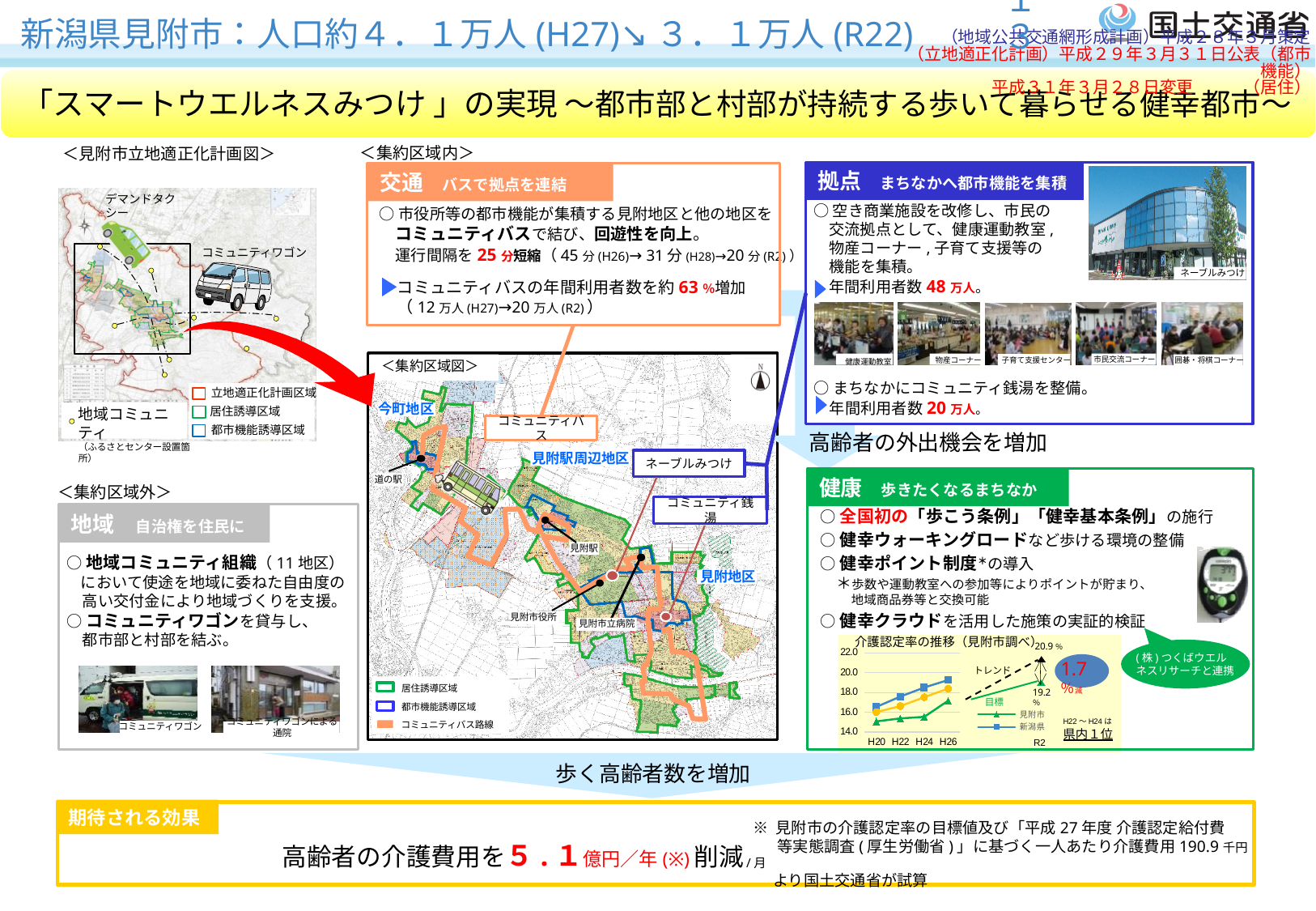
In the 介護認定率の推移 chart, does the 見附市 line rise or fall from H20 to H26? rise In the 介護認定率の推移 chart, is the 見附市 value at H20 greater or less than 18.0? less In the 介護認定率の推移 chart, what value is labelled for the トレンド line at R2? 20.9% What is the title of the chart in the 健康 panel? 介護認定率の推移（見附市調べ） In the 介護認定率の推移 chart, is the 見附市 value at H26 greater or less than 18.0? less What kind of chart is the 介護認定率の推移（見附市調べ） chart? line chart In the 介護認定率の推移 chart, which is larger at R2: the トレンド value or the 目標 value? トレンド How many series does the legend of the 介護認定率の推移 chart list? 2 How many x-axis labels are shown on the 介護認定率の推移 chart? 5 In the 介護認定率の推移 chart, what value is labelled for the 目標 line at R2? 19.2% In the 介護認定率の推移 chart, what is the difference between the トレンド value (20.9%) and the 目標 value (19.2%) at R2? 1.7%